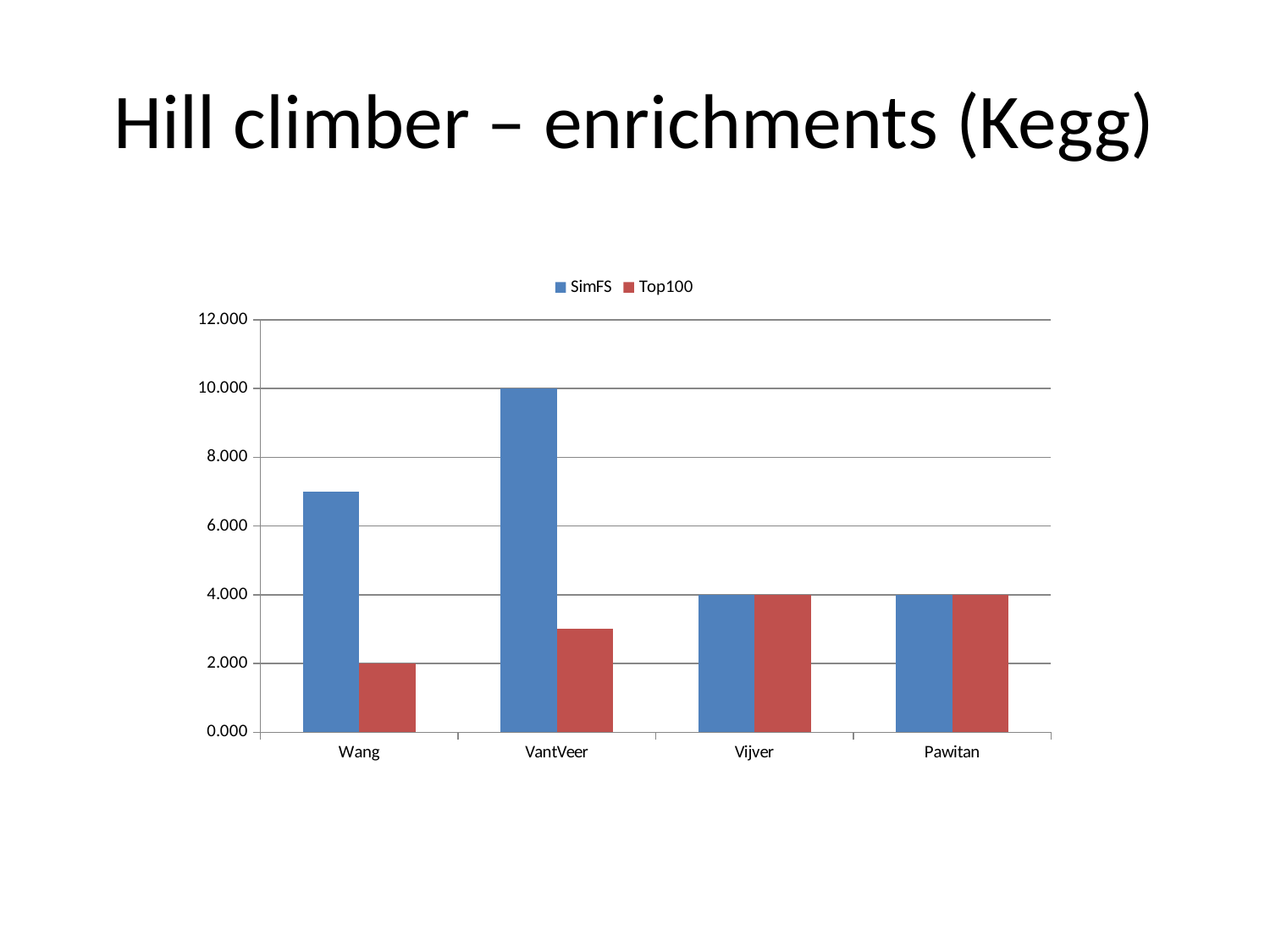
Which category has the highest SimFS value? VantVeer How many categories are shown on the x axis? 4 Which category has the lowest Top100 value? Wang What is the Top100 value for Wang? 2.000 Is the SimFS value for Wang greater or less than 6.000? greater What is the SimFS value for VantVeer? 10.000 What is the Top100 value for Pawitan? 4.000 How many series does the legend list? 2 What kind of chart is shown on the slide? bar chart What is the difference between the SimFS value for VantVeer and the Top100 value for Wang? 8.000 What is the SimFS value for Vijver? 4.000 For VantVeer, which series has the larger value, SimFS or Top100? SimFS